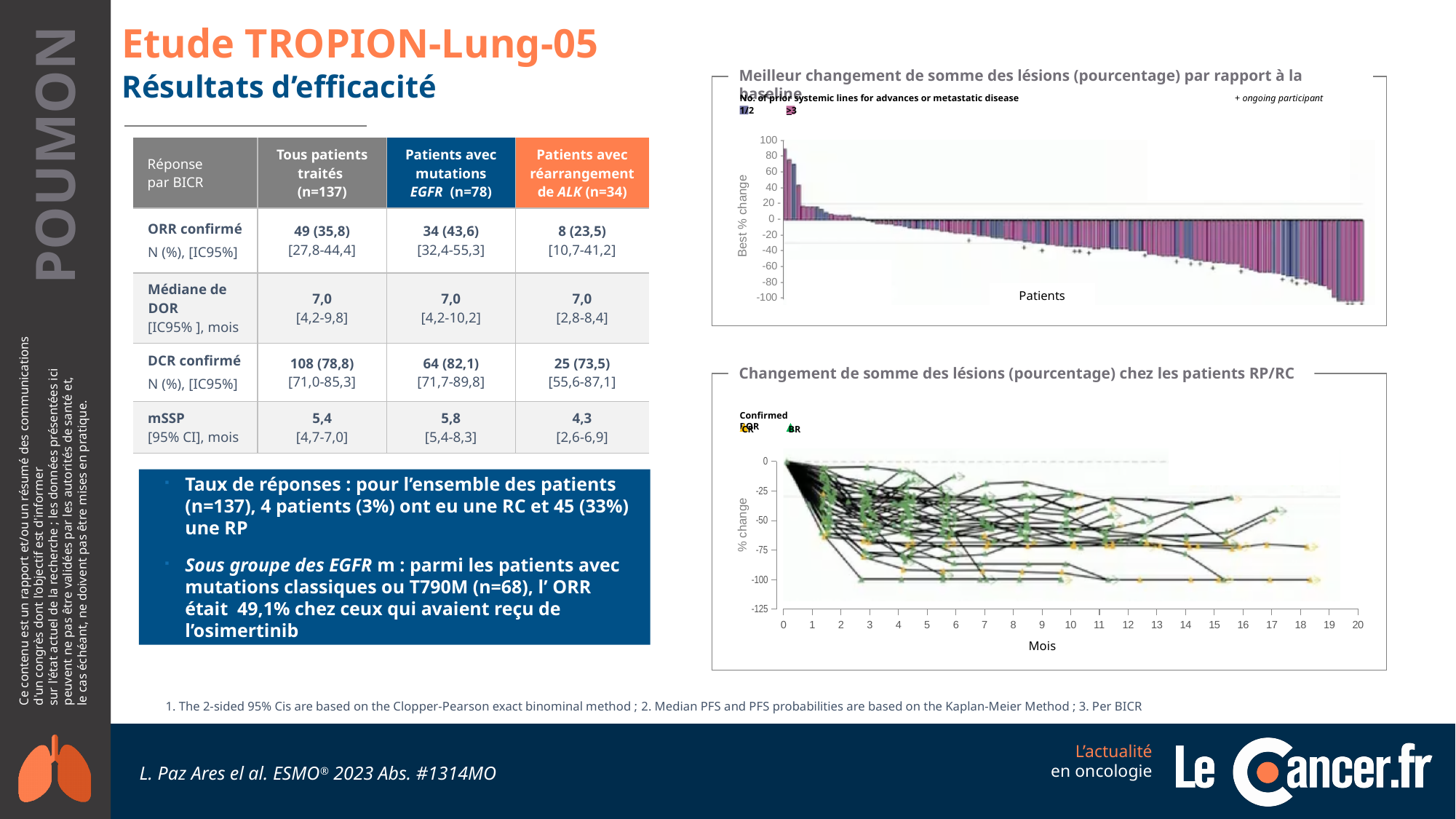
How many series does the legend of the top-right bar chart list? 2 In the top-right bar chart, what is the label of the y axis? Best % change In the bottom-right line chart, what is the highest value shown on the x axis? 20 In the top-right bar chart, is the value of the lowest bar on the far right greater or less than -80? less What kind of chart is the top-right chart titled 'Meilleur changement de somme des lésions (pourcentage) par rapport à la baseline'? Bar chart In the bottom-right line chart, what is the label of the x axis? Mois In the top-right bar chart, what is the label of the x axis? Patients In the top-right bar chart, is the value of the tallest bar on the left greater or less than 60? greater In the top-right bar chart, do the bar values rise or fall from left to right along the x axis? Fall What kind of chart is the bottom-right chart titled 'Changement de somme des lésions (pourcentage) chez les patients RP/RC'? Line chart In the bottom-right line chart, what is the lowest tick value shown on the y axis? -125 How many series does the legend of the bottom-right line chart list? 2